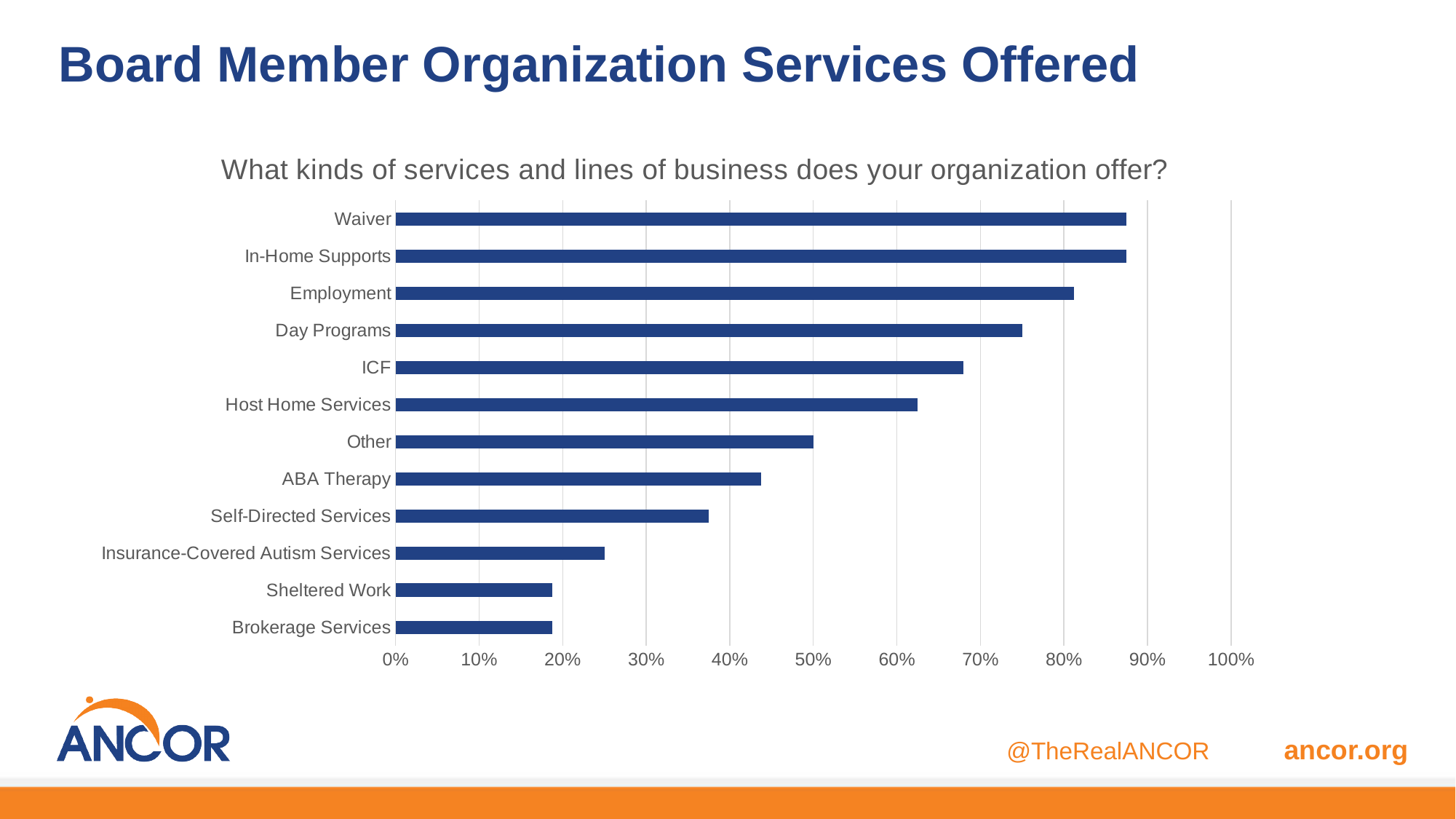
Is the value for Host Home Services greater or less than 60%? greater Is the value for Waiver greater or less than 80%? greater Is the value for ICF greater or less than 70%? less How many service categories are plotted in the chart? 12 Which has a larger value, Employment or Day Programs? Employment What kind of chart is shown on the slide? bar chart What question is shown as the chart's title? What kinds of services and lines of business does your organization offer? Which has a larger value, ABA Therapy or Self-Directed Services? ABA Therapy